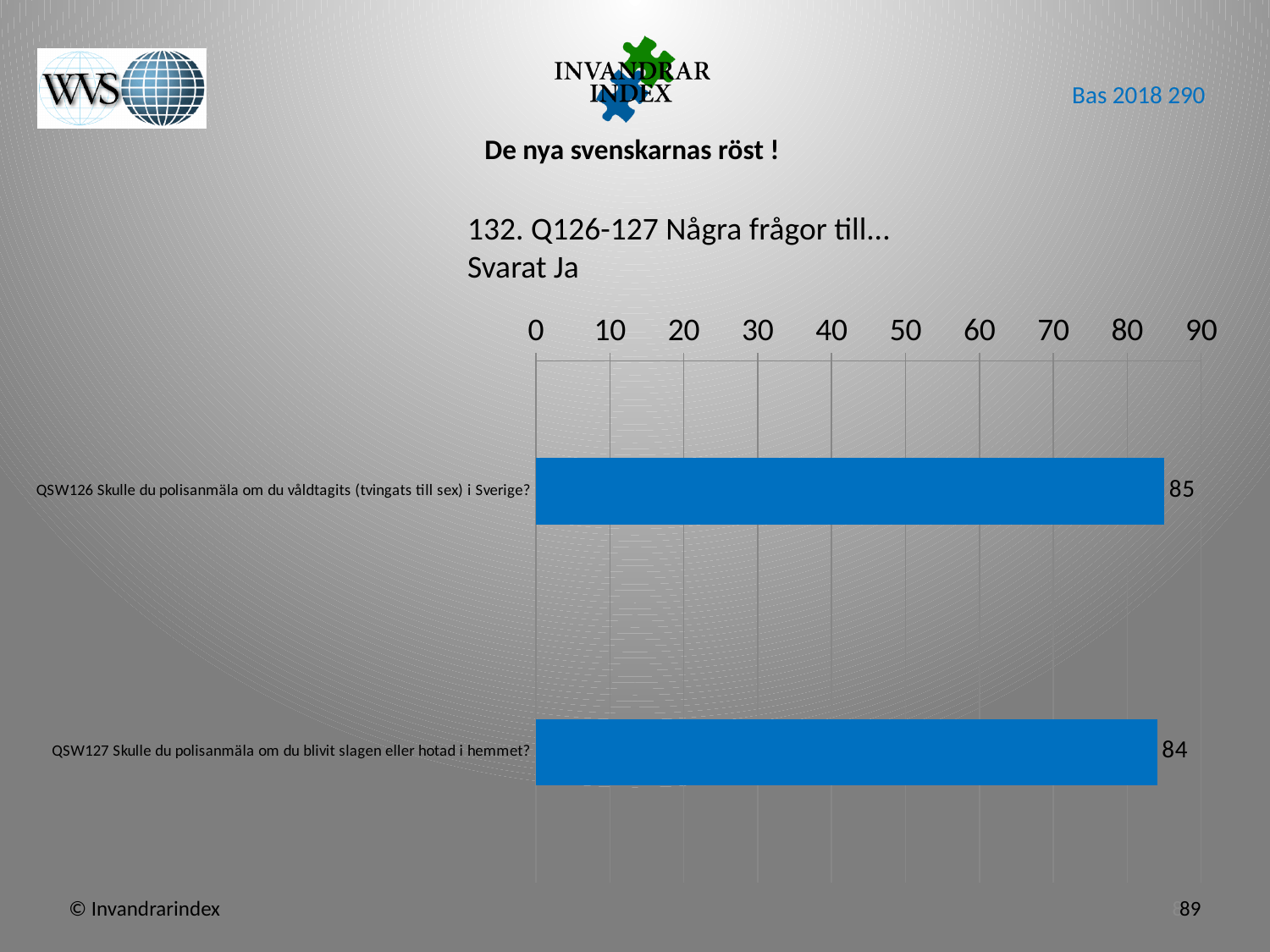
What is the difference between the values for QSW126 and QSW127? 1 How many categories are shown in the chart? 2 What is the title of the chart? 132. Q126-127 Några frågor till… Svarat Ja Which category has the highest value? QSW126 Skulle du polisanmäla om du våldtagits (tvingats till sex) i Sverige? Which category has the lowest value? QSW127 Skulle du polisanmäla om du blivit slagen eller hotad i hemmet? Is the value for QSW127 greater or less than 80? greater What value is shown for QSW126 (Skulle du polisanmäla om du våldtagits (tvingats till sex) i Sverige?)? 85 What is the highest value shown on the chart's axis? 90 What kind of chart is shown on the slide? bar chart Which has a larger value, QSW126 or QSW127? QSW126 What value is shown for QSW127 (Skulle du polisanmäla om du blivit slagen eller hotad i hemmet?)? 84